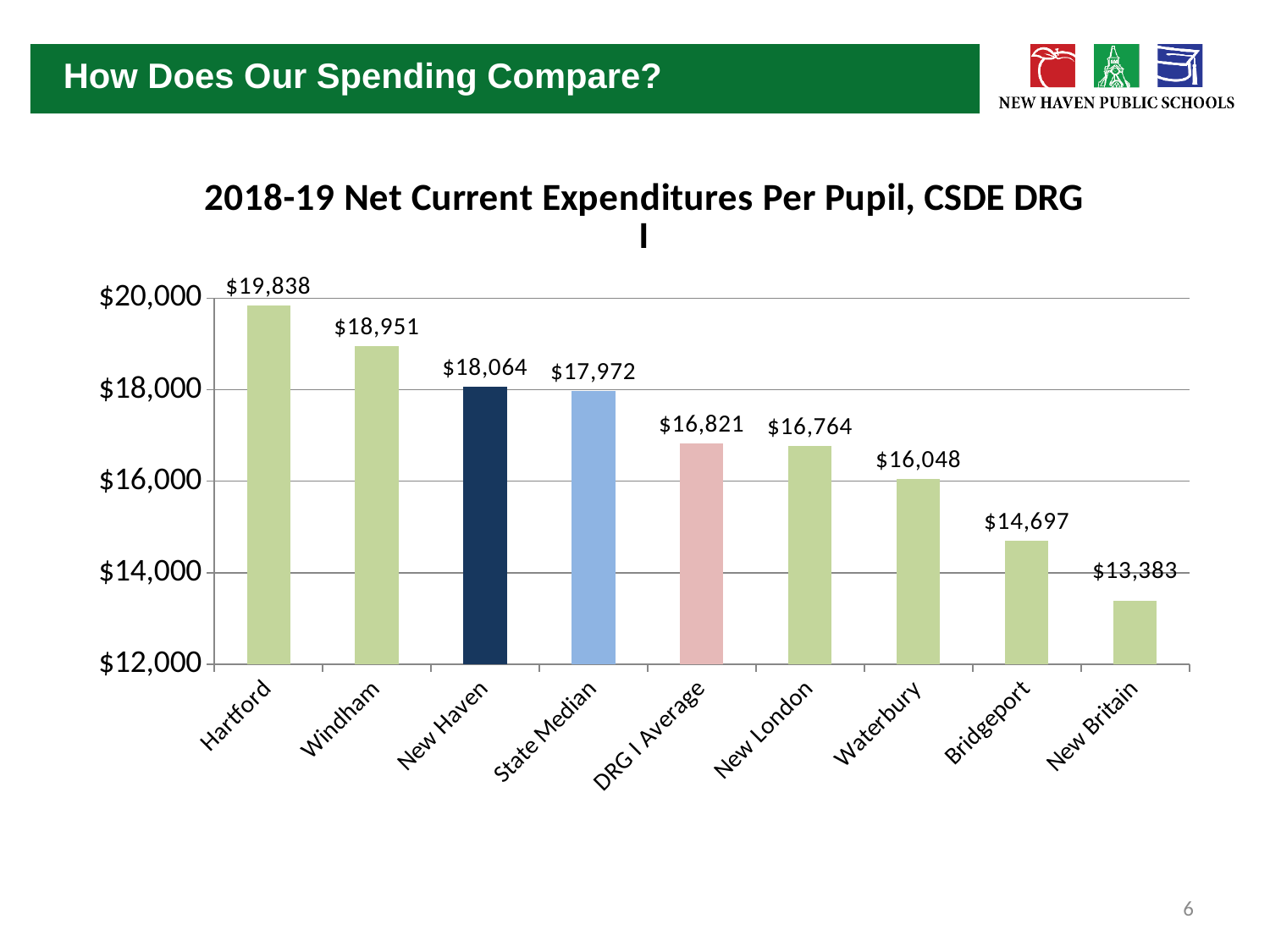
Do the values rise or fall moving from left to right along the x axis? Fall What is the value shown for the State Median? $17,972 Is the value for New London greater or less than $18,000? less Which category has the lowest net current expenditure per pupil? New Britain How much higher is New Haven's value than the DRG I Average? $1,243 Which is larger, the value for Windham or the value for Bridgeport? Windham What is the value shown for Waterbury? $16,048 Which category has the highest net current expenditure per pupil? Hartford How many categories are shown on the x axis? 9 What is the net current expenditure per pupil for New Haven? $18,064 What kind of chart is shown on the slide? Bar chart What is the difference between Hartford's value and New Britain's value? $6,455